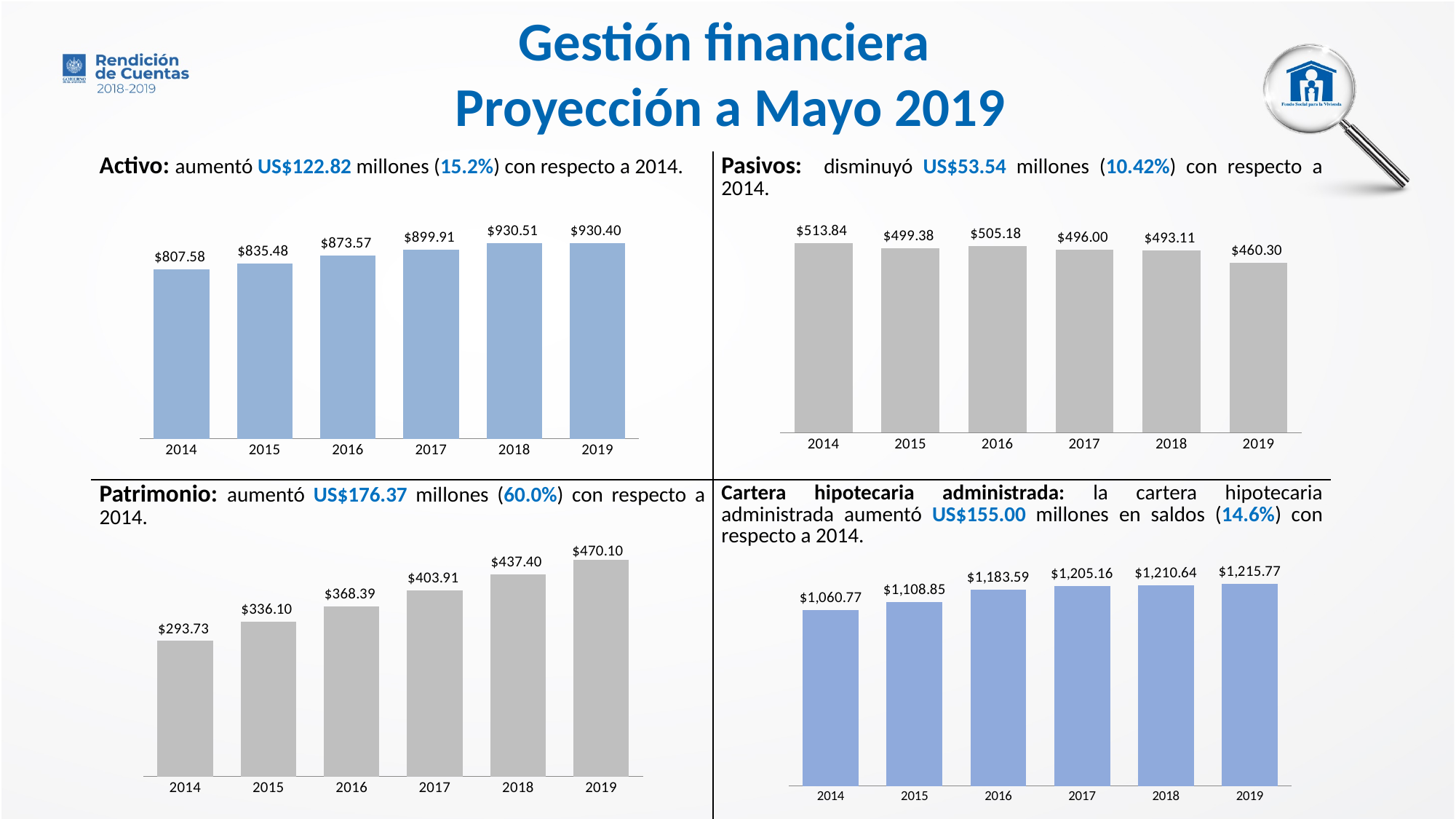
In the Patrimonio chart (bottom-left), what is the difference between the 2019 and 2014 values? $176.37 In the Activo chart (top-left), what is the value for 2014? $807.58 In the Pasivos chart (top-right), which year has the lowest value? 2019 What kind of chart is the Cartera hipotecaria administrada chart (bottom-right)? Bar chart In the Patrimonio chart (bottom-left), do the values rise or fall from 2014 to 2019? Rise In the Activo chart (top-left), which year has the lowest value? 2014 In the Patrimonio chart (bottom-left), which year has the highest value? 2019 In the Cartera hipotecaria administrada chart (bottom-right), which is larger, the value for 2015 or the value for 2018? 2018 How many years are shown in the Pasivos chart (top-right)? 6 In the Pasivos chart (top-right), what is the value for 2019? $460.30 In the Patrimonio chart (bottom-left), what is the value for 2017? $403.91 In the Cartera hipotecaria administrada chart (bottom-right), what is the value for 2016? $1,183.59